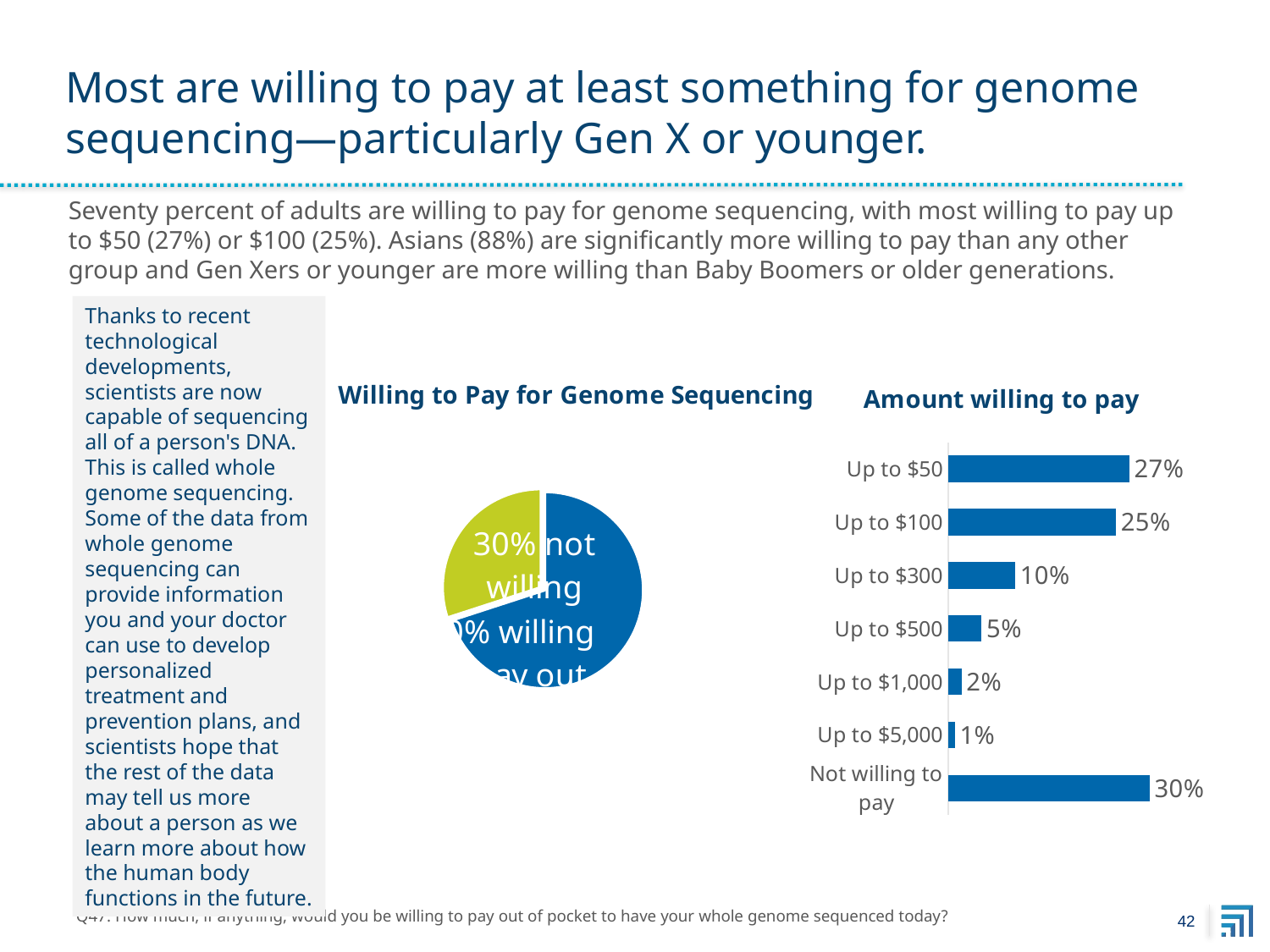
In the 'Amount willing to pay' chart, which category has the highest value? Not willing to pay In the 'Amount willing to pay' chart, which category has the lowest value? Up to $5,000 In the 'Amount willing to pay' chart, what percentage are willing to pay up to $50? 27% In the 'Amount willing to pay' chart, what percentage are willing to pay up to $300? 10% In the 'Amount willing to pay' chart, what is the difference between the 'Up to $50' and 'Up to $100' values? 2% What kind of chart is 'Willing to Pay for Genome Sequencing'? Pie chart In the 'Amount willing to pay' chart, what is the combined value of 'Up to $50' and 'Up to $100'? 52% In the 'Willing to Pay for Genome Sequencing' pie chart, what share is labelled 'not willing'? 30% What kind of chart is 'Amount willing to pay'? Bar chart In the 'Amount willing to pay' chart, which is larger: 'Up to $500' or 'Up to $1,000'? Up to $500 How many categories are shown in the 'Amount willing to pay' chart? 7 In the 'Amount willing to pay' chart, what percentage are willing to pay up to $5,000? 1%